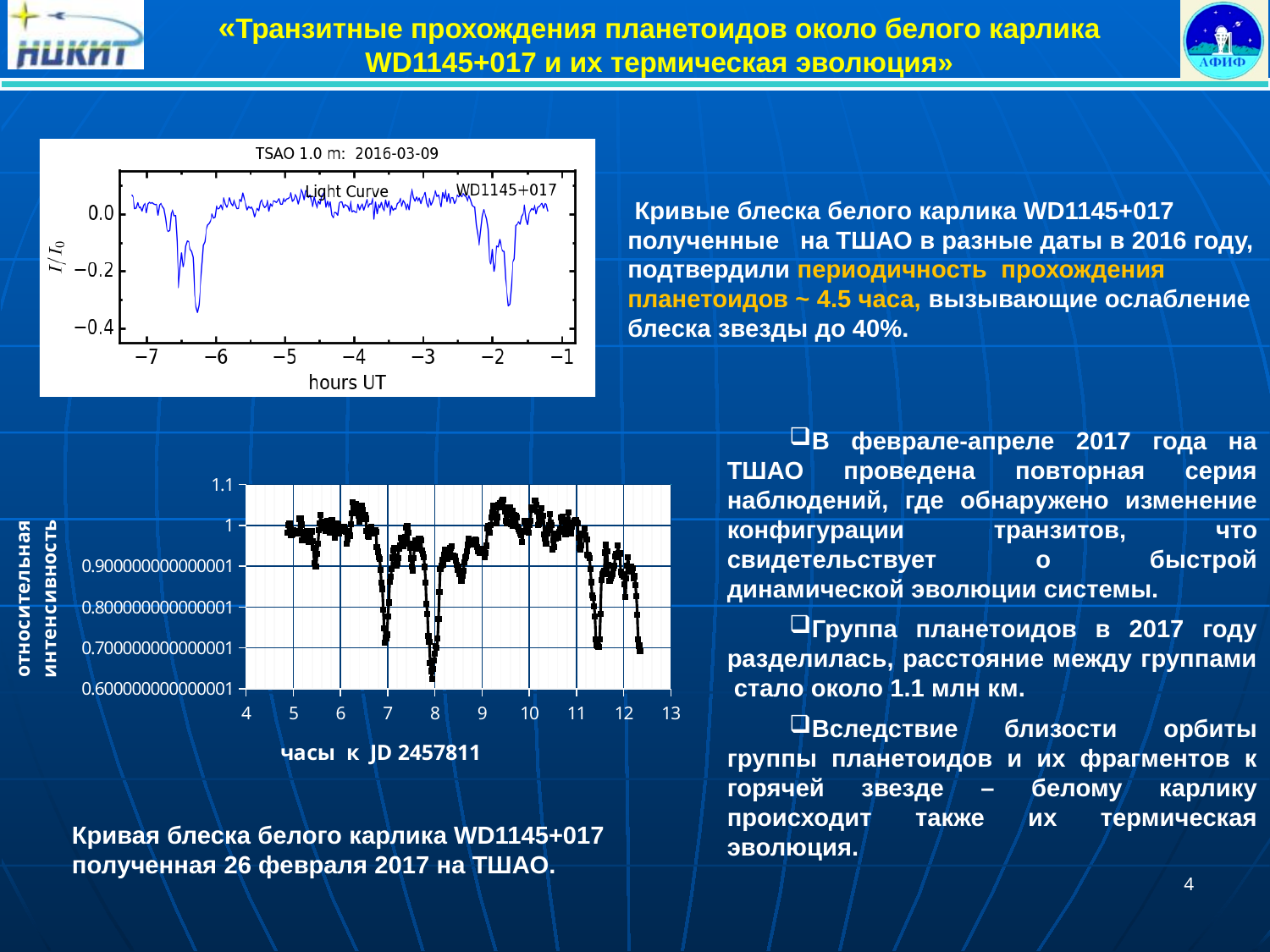
What kind of chart is the top-left chart titled 'TSAO 1.0 m: 2016-03-09'? line chart What is the x-axis label of the bottom-left chart? часы к JD 2457811 On the bottom-left chart, is the relative intensity at hour 9.5 greater or less than 0.9? greater On the top-left chart, is the value of I/I0 at the dip near -6 hours UT greater or less than -0.2? less On the top-left chart, is the value of I/I0 at -4 hours UT greater or less than -0.2? greater What is the y-axis label of the bottom-left chart? относительная интенсивность What are the two legend entries shown on the top-left chart? Light Curve, WD1145+017 What kind of chart is the bottom-left chart with x axis 'часы к JD 2457811'? scatter chart